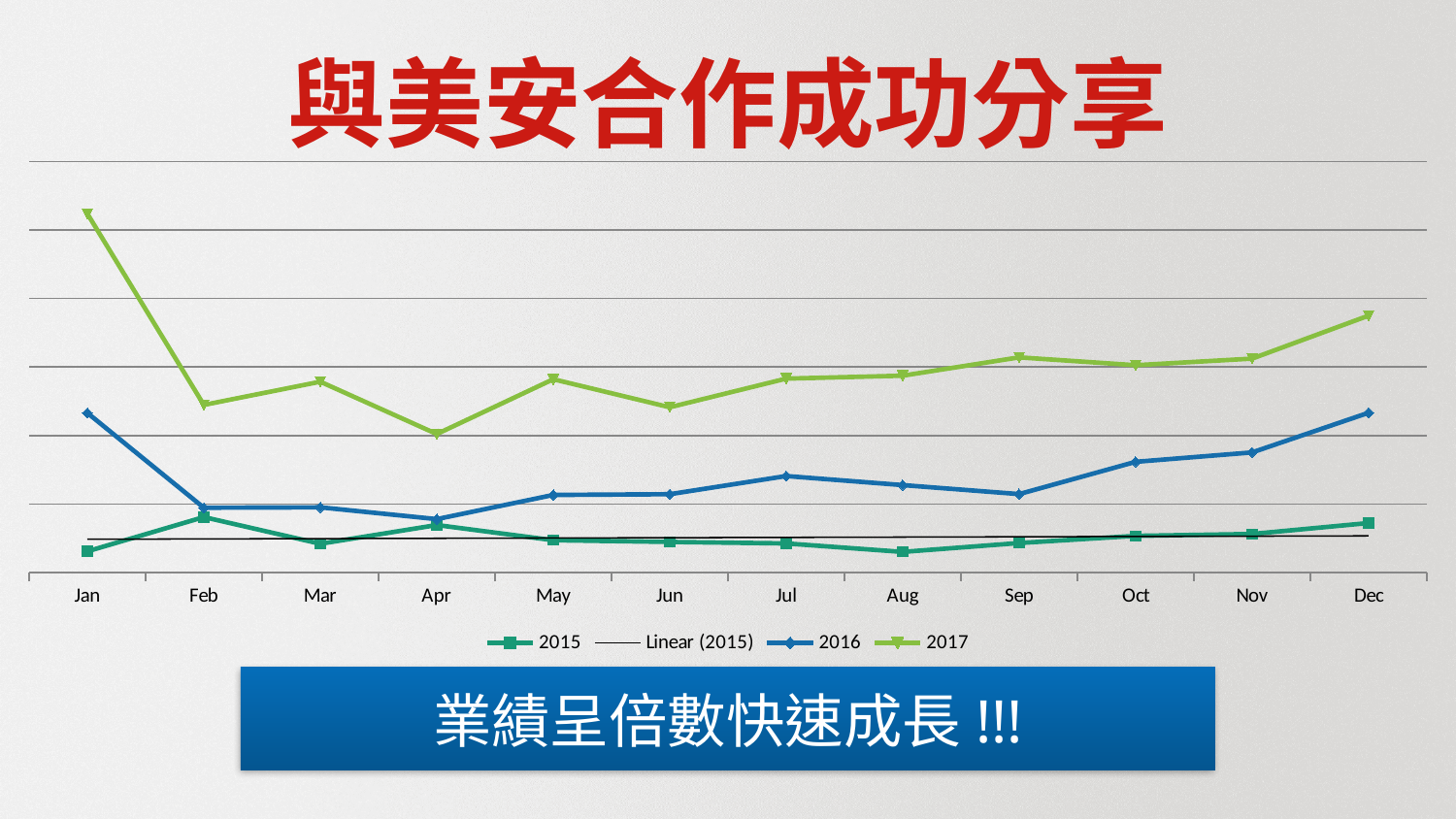
What colour is the line for the 2017 series? Light green In Jan, which series has the higher value, 2016 or 2017? 2017 In which month does the 2017 series reach its highest value? Jan How many entries does the chart's legend list? 4 In which month does the 2017 series reach its lowest value? Apr In Dec, which series has the higher value, 2015 or 2016? 2016 In Jan, which series has the lower value, 2015 or 2016? 2015 What kind of chart is shown on the slide? Line chart Does the 2017 series rise or fall from Jan to Feb? Fall How many months are shown along the x axis of the chart? 12 Does the 2016 series rise or fall from Sep to Dec? Rise Which legend entry is drawn as a thin black line? Linear (2015)